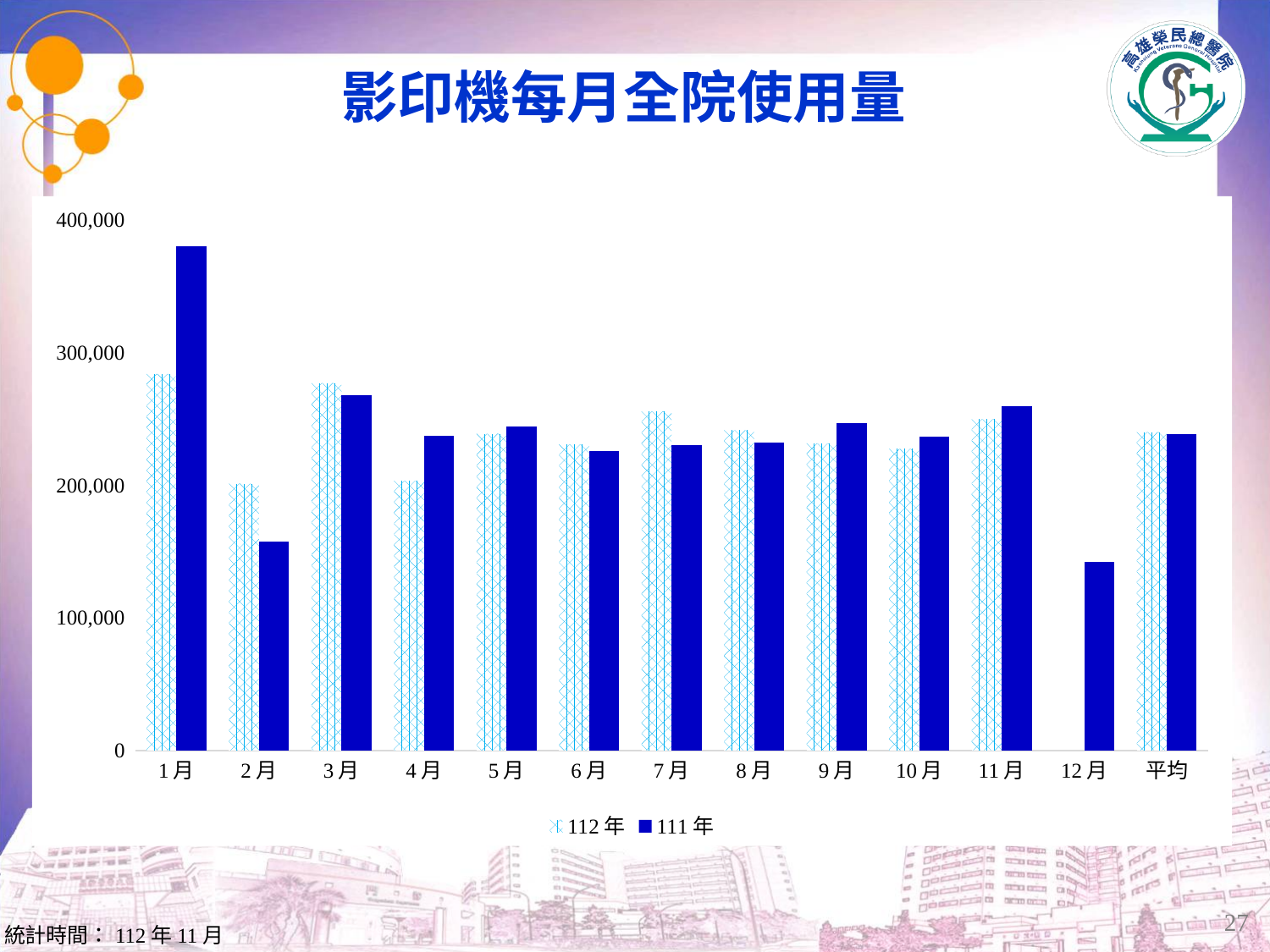
How many categories are shown along the x axis? 13 What is the title of the chart? 影印機每月全院使用量 Is the 112年 value for 1月 greater or less than 300,000? less Which month has the highest value for the 111年 series? 1月 How many series does the legend list? 2 Is the 111年 value for 1月 greater or less than 300,000? greater For 1月, which series has the larger value, 112年 or 111年? 111年 What kind of chart is shown on the slide? bar chart Is the 111年 value for 2月 greater or less than 200,000? less What are the two series named in the legend? 112年 and 111年 For 2月, which series has the larger value, 112年 or 111年? 112年 Which month has the lowest value for the 111年 series? 12月